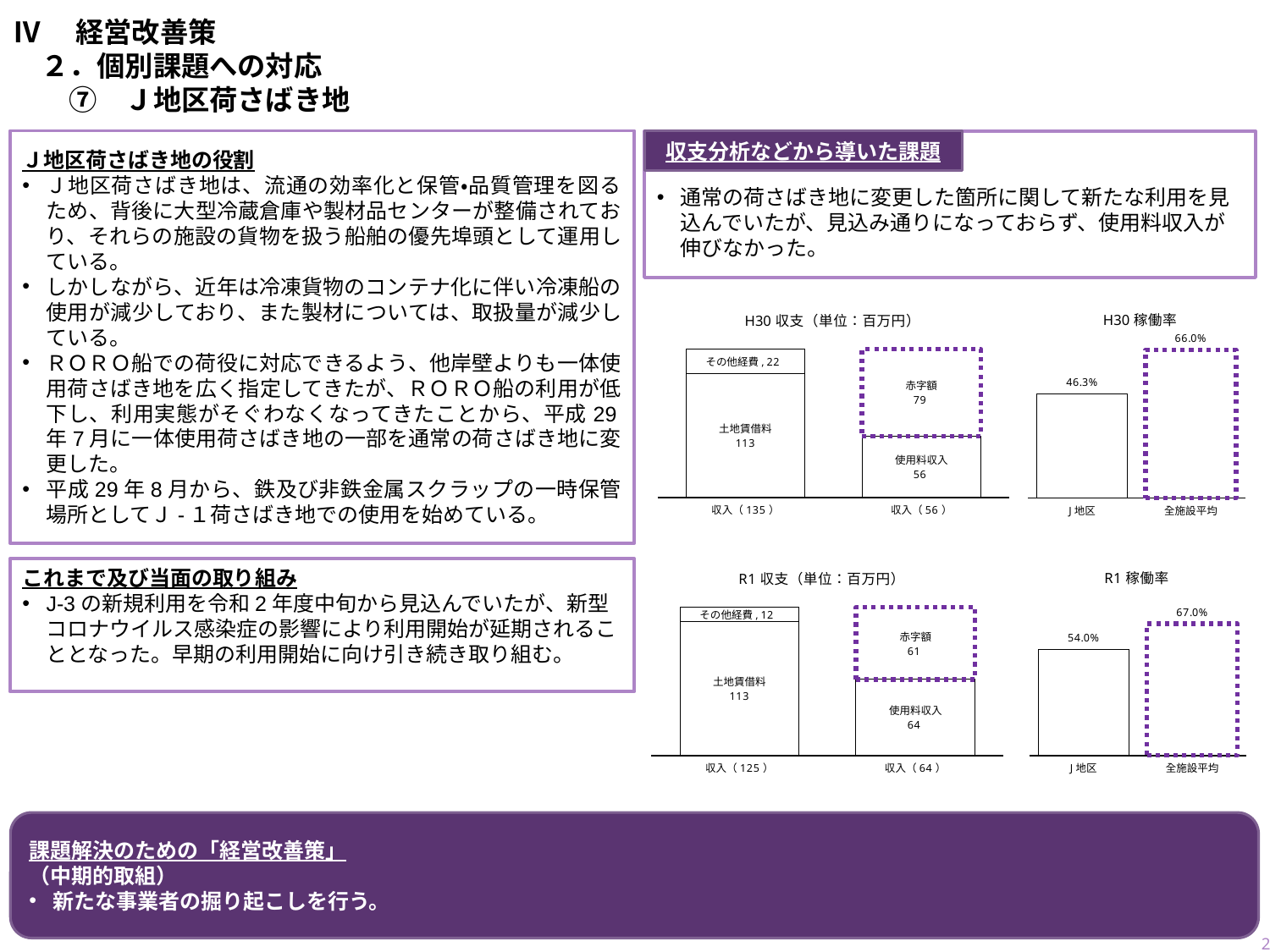
In the R1 収支 chart, what is the total of the left stacked bar (その他経費 plus 土地賃借料)? 125 In the R1 稼働率 chart, what is the value for J地区? 54.0% In the R1 収支 chart, what is the value of その他経費? 12 In the H30 稼働率 chart, what is the value for 全施設平均? 66.0% In the H30 稼働率 chart, what is the value for J地区? 46.3% In the R1 稼働率 chart, which is larger, J地区 or 全施設平均? 全施設平均 In the R1 稼働率 chart, what is the value for 全施設平均? 67.0% In the H30 収支 chart, what is the difference between 土地賃借料 and その他経費? 91 In the R1 収支 chart, what is the value of 土地賃借料? 113 In the H30 収支 chart, what is the value of 使用料収入? 56 In the H30 収支 chart, what is the value of 赤字額? 79 What kind of chart is the H30 稼働率 chart? bar chart